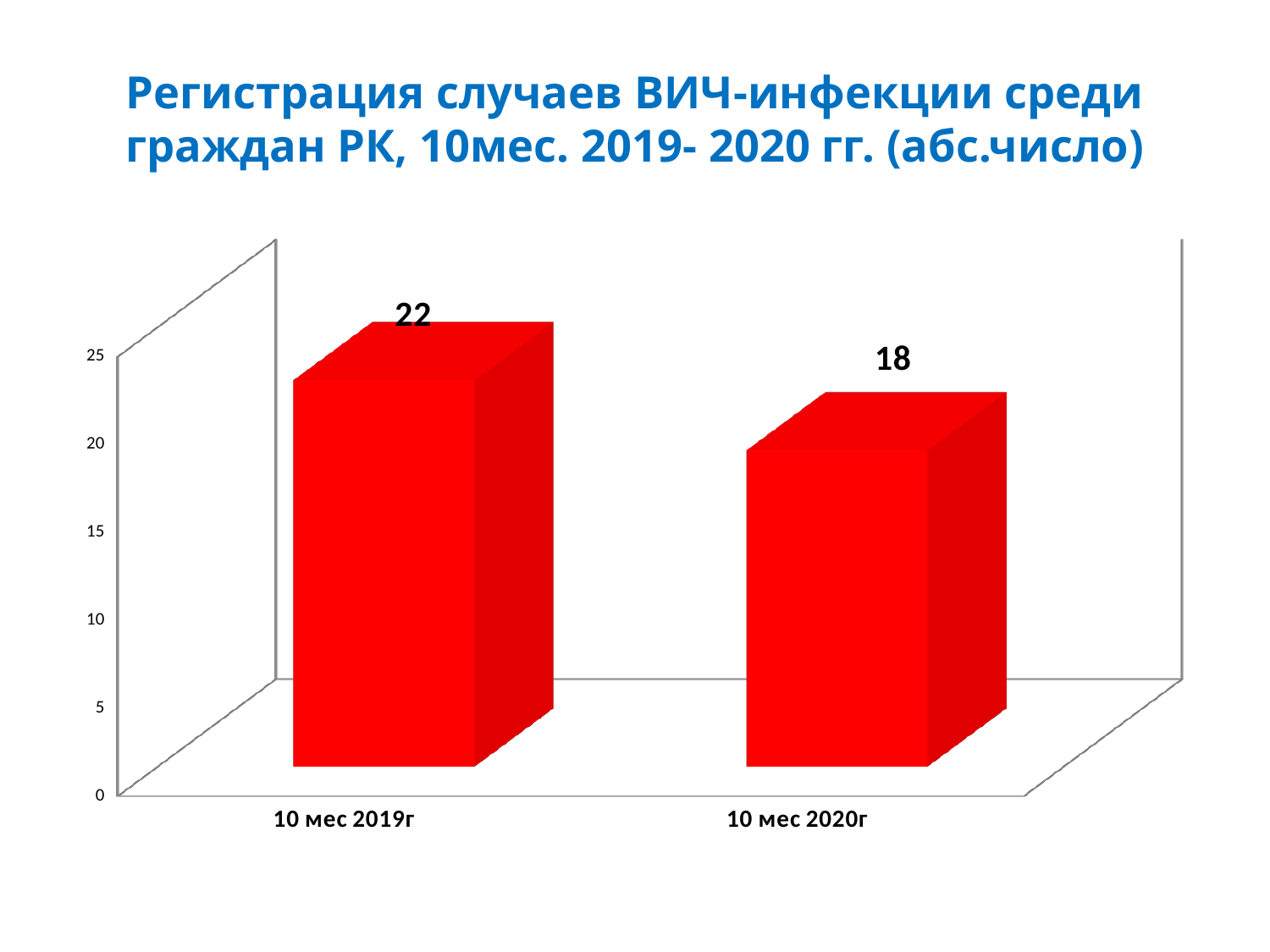
What kind of chart is shown on the slide? bar chart What is the difference between the values for 10 мес 2019г and 10 мес 2020г? 4 Which is larger, the value for 10 мес 2019г or 10 мес 2020г? 10 мес 2019г Is the value for 10 мес 2019г greater or less than 20? greater How many categories are shown on the x axis? 2 Do the values rise or fall from 10 мес 2019г to 10 мес 2020г? fall Which category has the lowest value? 10 мес 2020г Which category has the highest value? 10 мес 2019г What is the value for 10 мес 2020г? 18 Is the value for 10 мес 2020г greater or less than 20? less What is the value for 10 мес 2019г? 22 What colour are the bars in the chart? red